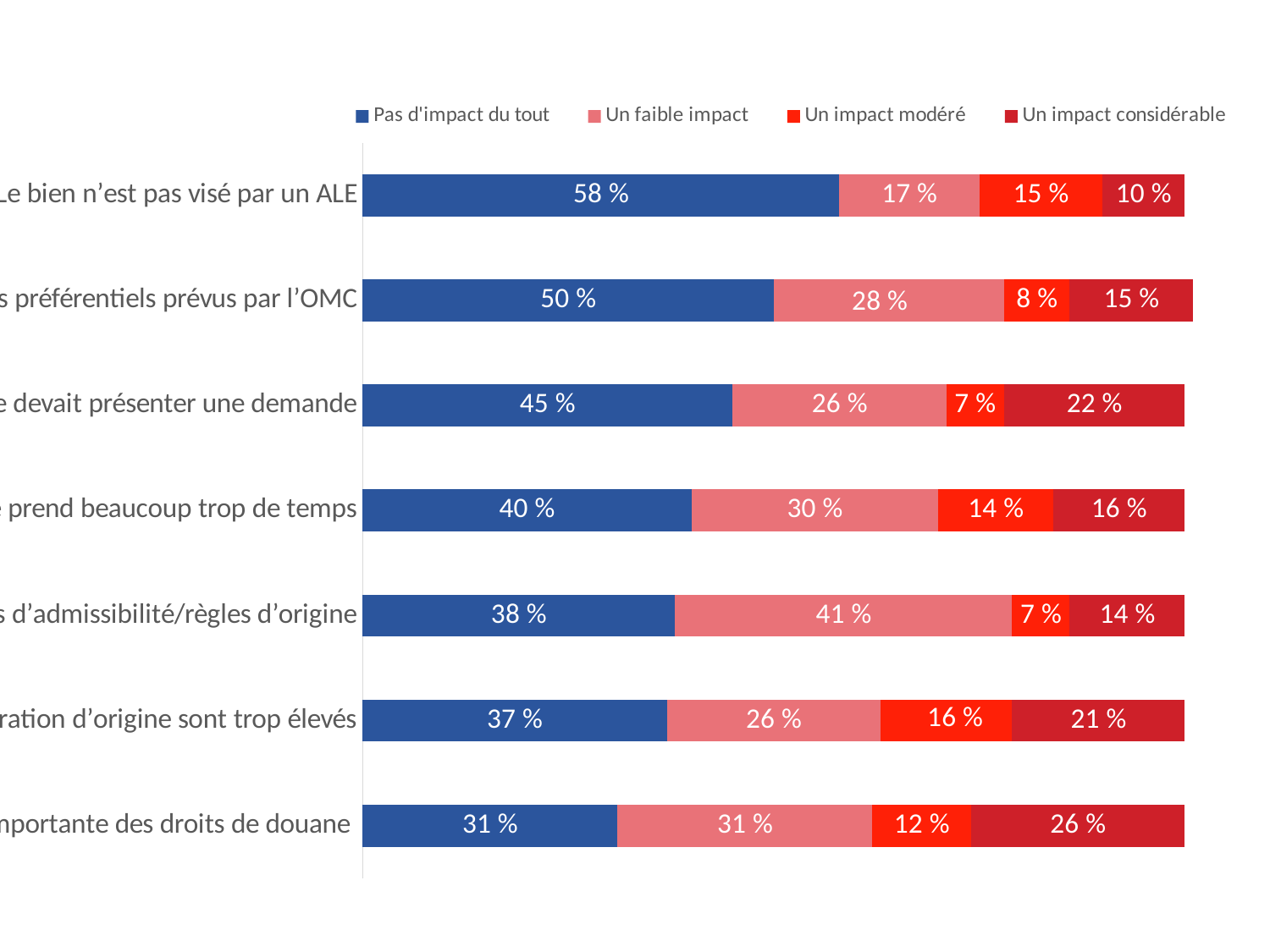
What is the difference between the 'Un impact modéré' values for the category ending in 'trop de temps' and the category ending in 'prévus par l'OMC'? 6 % What is the 'Pas d'impact du tout' value for the category 'Le bien n'est pas visé par un ALE'? 58 % Which is larger: the 'Un impact considérable' value for the category ending in 'présenter une demande' or for the category ending in 'sont trop élevés'? The category ending in 'présenter une demande' (22 %) How many categories (bars) are shown in the chart? 7 What kind of chart is shown on the slide? Stacked bar chart Which category has the lowest 'Pas d'impact du tout' value? The category ending in 'des droits de douane' What is the 'Un impact considérable' value for the category ending in 'des droits de douane'? 26 % Which category has the highest 'Pas d'impact du tout' value? Le bien n'est pas visé par un ALE Which legend entry is shown in dark blue? Pas d'impact du tout How many series does the legend list? 4 What is the 'Un faible impact' value for the category ending in 'règles d'origine'? 41 % What is the total of the stacked bar for the category ending in 'trop de temps'? 100 %